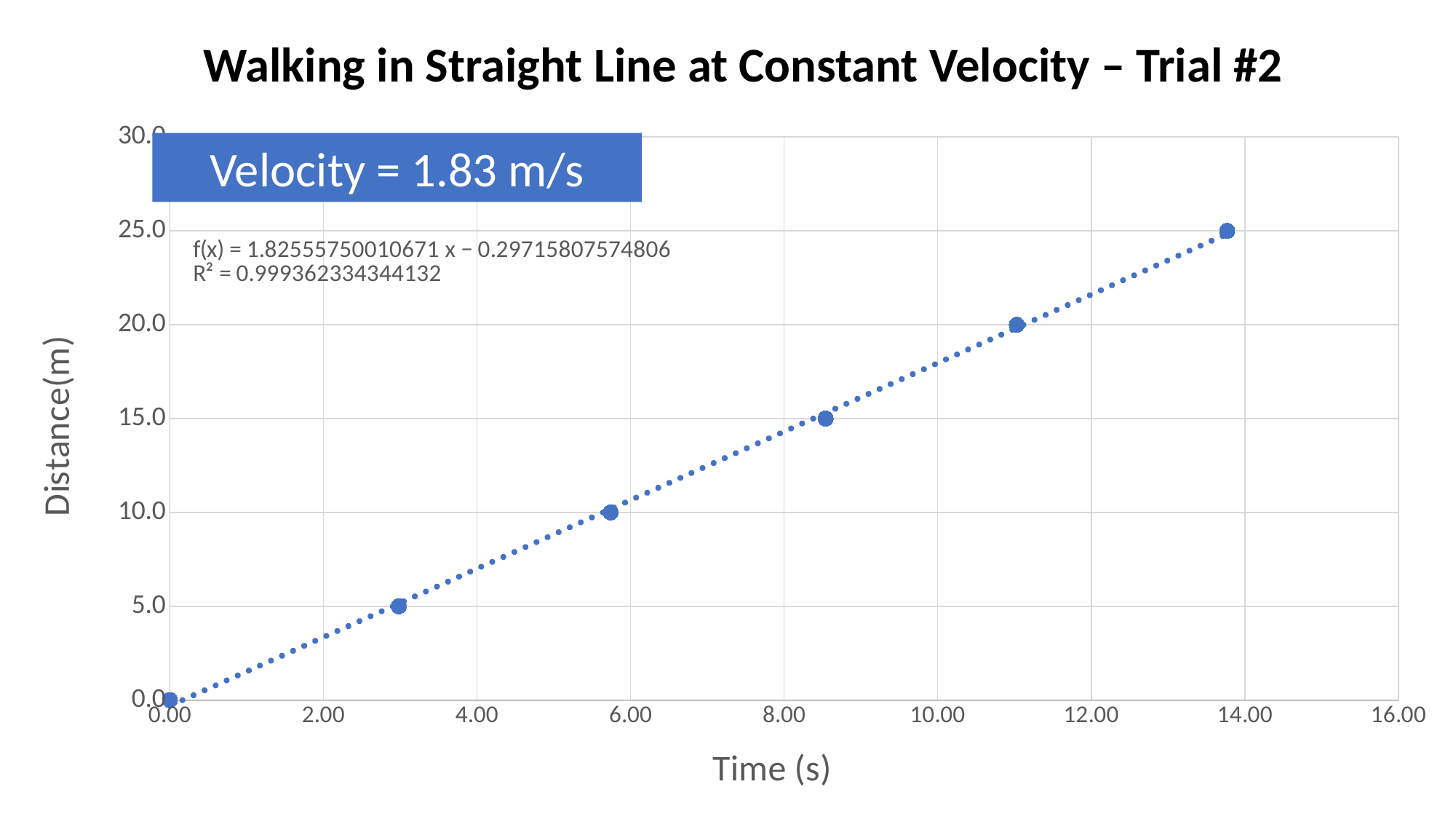
Do the distance values rise or fall as time increases along the x axis? rise Is the time value for the point at 15.0 m greater or less than 8.00? greater Which point has a larger distance value: the one near 3 s or the one near 11 s? the one near 11 s What is the highest distance value reached by a plotted point? 25.0 What is the lowest distance value of a plotted point? 0.0 What kind of chart is shown on the slide? scatter chart How many data points are plotted on the chart? 6 Is the time value for the point at 20.0 m greater or less than 10.00? greater What velocity is stated in the box on the chart? 1.83 m/s Is the time value for the point at 10.0 m greater or less than 6.00? less What is the difference in distance between the highest point (25.0 m) and the point at 5.0 m? 20.0 What is the title of the chart? Walking in Straight Line at Constant Velocity – Trial #2